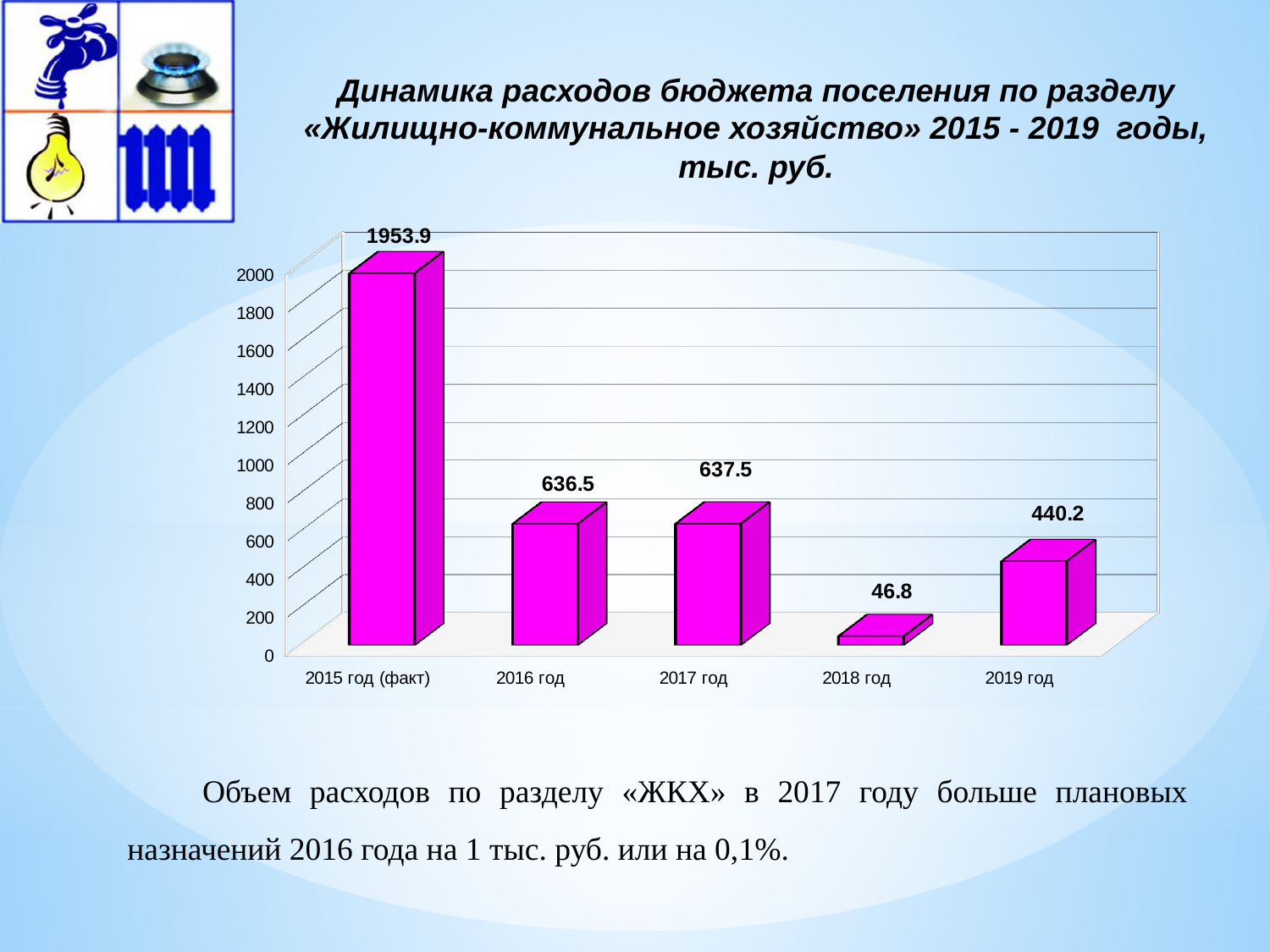
Which is larger, the value for 2016 год or the value for 2019 год? 2016 год What colour are the bars in the chart? magenta Is the value for 2019 год greater or less than 600? less Which year has the lowest value? 2018 год What is the value for 2019 год? 440.2 How many years are shown on the chart? 5 What is the difference between the values for 2015 год (факт) and 2019 год? 1513.7 What is the value for 2015 год (факт)? 1953.9 What is the difference between the values for 2017 год and 2016 год? 1 Which year has the highest value? 2015 год (факт) What kind of chart is shown on the slide? bar chart What is the value for 2018 год? 46.8